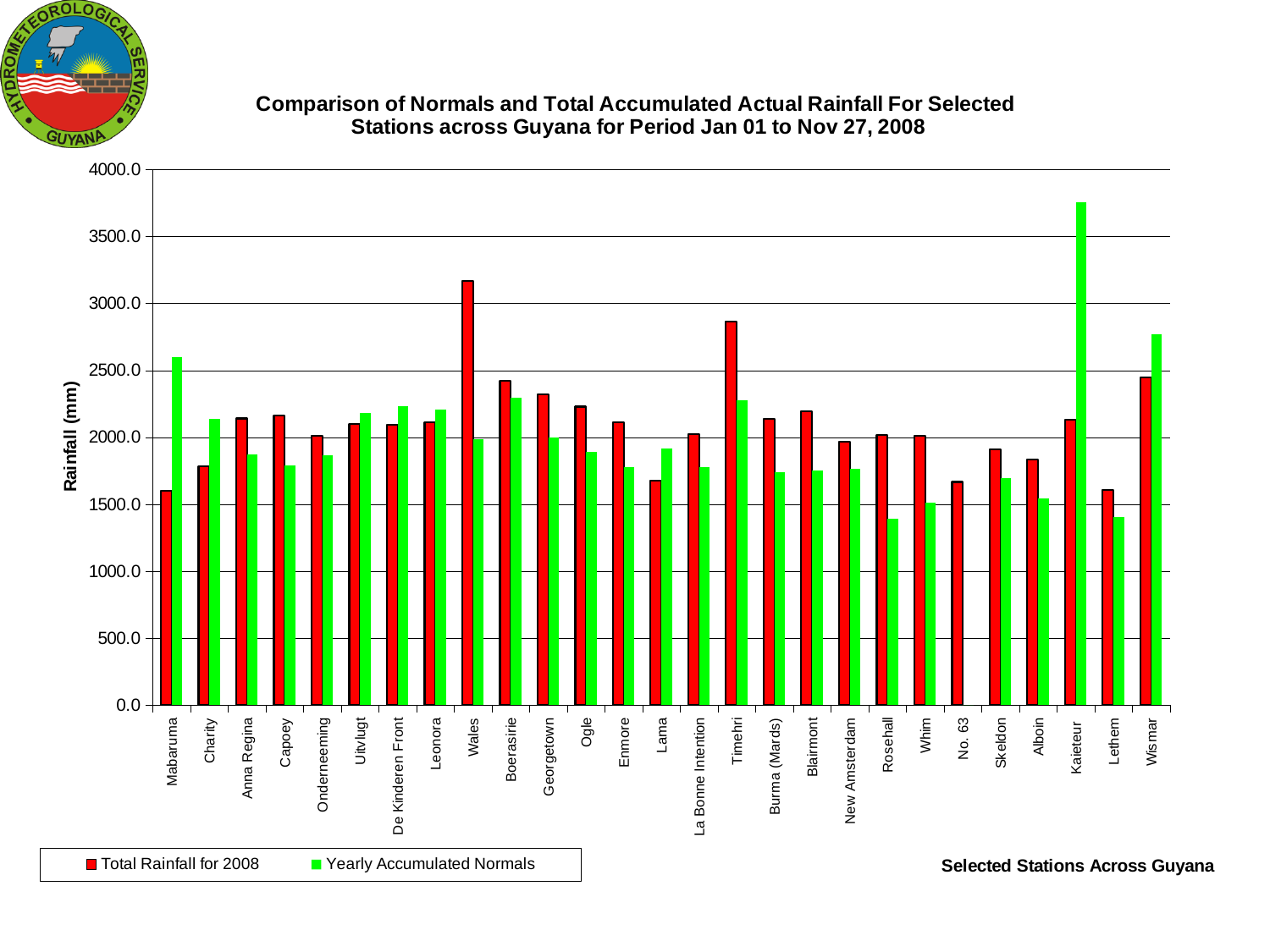
Which station has the highest Total Rainfall for 2008? Wales How many stations are shown along the x axis? 27 Is the Total Rainfall for 2008 at Wales greater or less than 3000.0? greater What kind of chart is shown on the slide? bar chart How many series does the legend list? 2 What is the label of the y axis? Rainfall (mm) Is the Total Rainfall for 2008 at Timehri greater or less than 2500.0? greater Is the Yearly Accumulated Normals value for Kaieteur greater or less than 3500.0? greater Which station has the highest Yearly Accumulated Normals value? Kaieteur At Mabaruma, which is larger: Total Rainfall for 2008 or Yearly Accumulated Normals? Yearly Accumulated Normals At Wales, which is larger: Total Rainfall for 2008 or Yearly Accumulated Normals? Total Rainfall for 2008